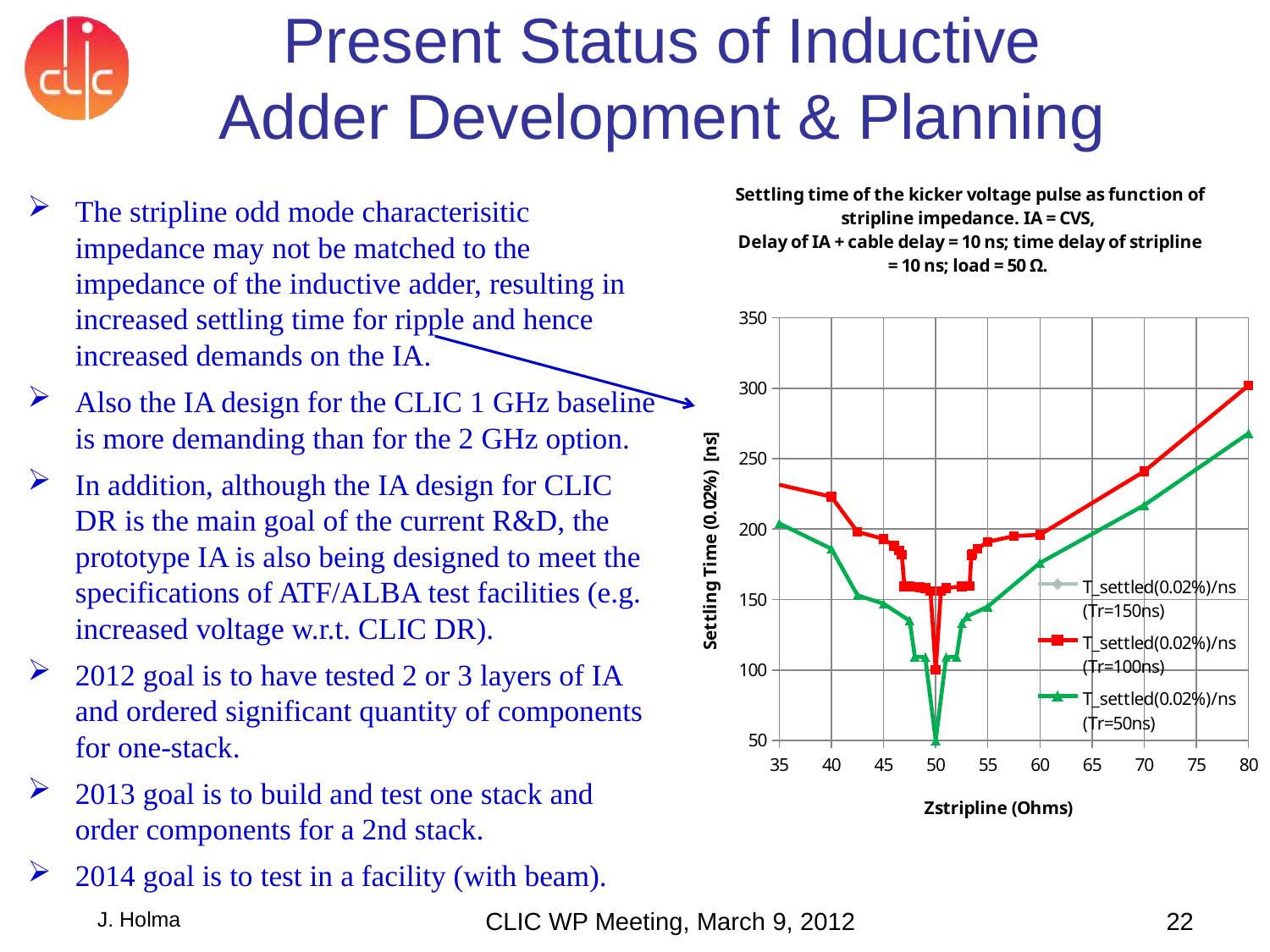
At which stripline impedance does the T_settled(0.02%)/ns (Tr=50ns) series reach its lowest settling time? 50 Ohms Is the value of the T_settled(0.02%)/ns (Tr=100ns) series at 80 Ohms greater or less than 250? greater What is the label of the y axis of the chart? Settling Time (0.02%) [ns] What kind of chart is shown on the slide? line chart How many series does the chart legend list? 3 At 80 Ohms, which series has the higher settling time: T_settled(0.02%)/ns (Tr=100ns) or T_settled(0.02%)/ns (Tr=50ns)? T_settled(0.02%)/ns (Tr=100ns) Between 55 Ohms and 80 Ohms, does the settling time of the T_settled(0.02%)/ns (Tr=100ns) series rise or fall? rise Is the value of the T_settled(0.02%)/ns (Tr=50ns) series at 40 Ohms greater or less than 200? less Is the value of the T_settled(0.02%)/ns (Tr=50ns) series at 60 Ohms greater or less than 200? less What is the label of the x axis of the chart? Zstripline (Ohms)